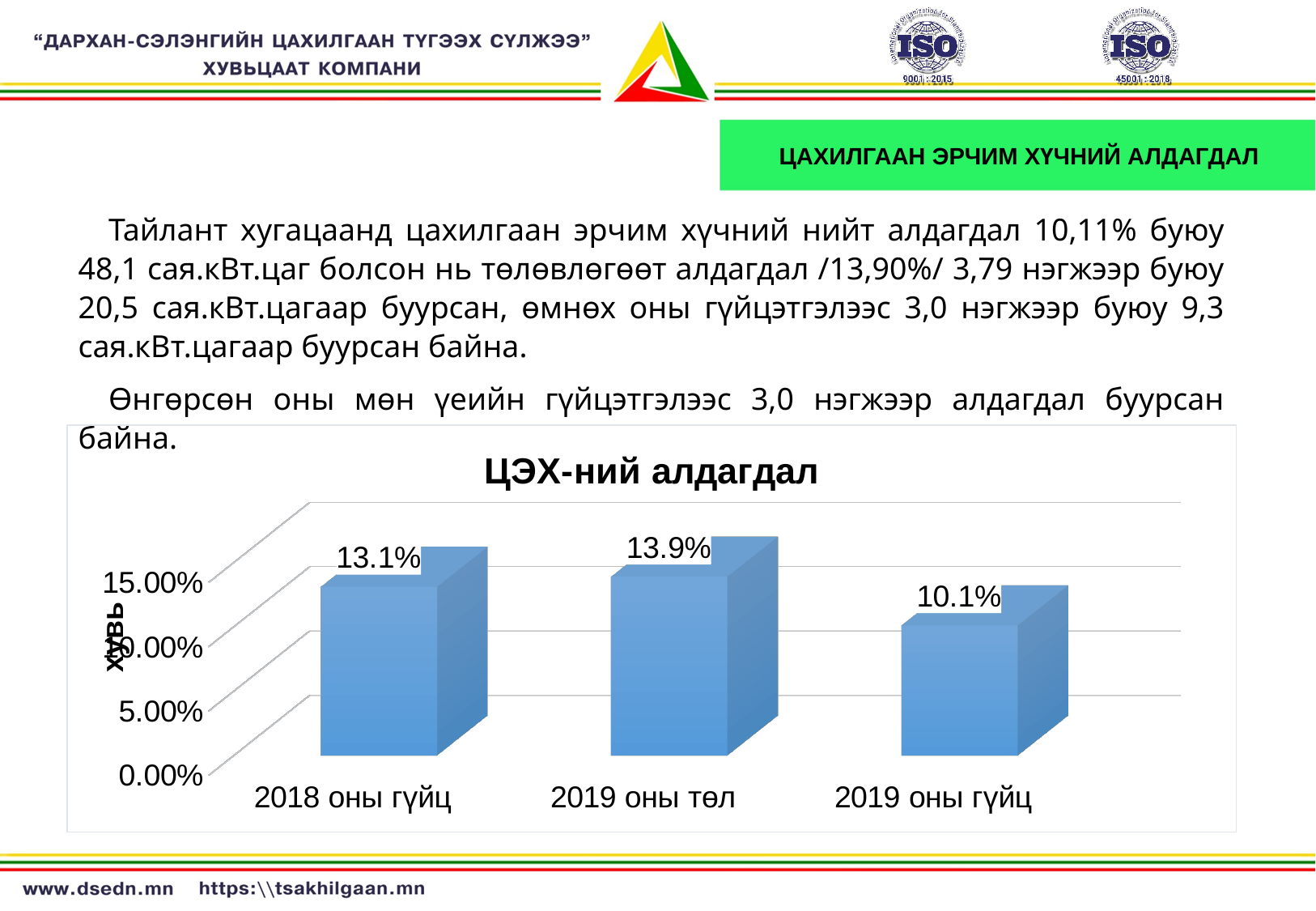
What is the title of the chart on the slide? ЦЭХ-ний алдагдал What is the value for 2018 оны гүйц in the ЦЭХ-ний алдагдал chart? 13.1% Which is larger, the value for 2018 оны гүйц or the value for 2019 оны төл? 2019 оны төл What is the value for 2019 оны гүйц in the ЦЭХ-ний алдагдал chart? 10.1% What kind of chart is the ЦЭХ-ний алдагдал chart? bar chart Which category has the highest value in the ЦЭХ-ний алдагдал chart? 2019 оны төл Is the value for 2019 оны гүйц greater or less than 15.00%? less What is the difference between the values for 2018 оны гүйц and 2019 оны гүйц? 3.0% What is the difference between the values for 2019 оны төл and 2019 оны гүйц? 3.8% How many categories are shown in the ЦЭХ-ний алдагдал chart? 3 What is the value for 2019 оны төл in the ЦЭХ-ний алдагдал chart? 13.9% Which category has the lowest value in the ЦЭХ-ний алдагдал chart? 2019 оны гүйц